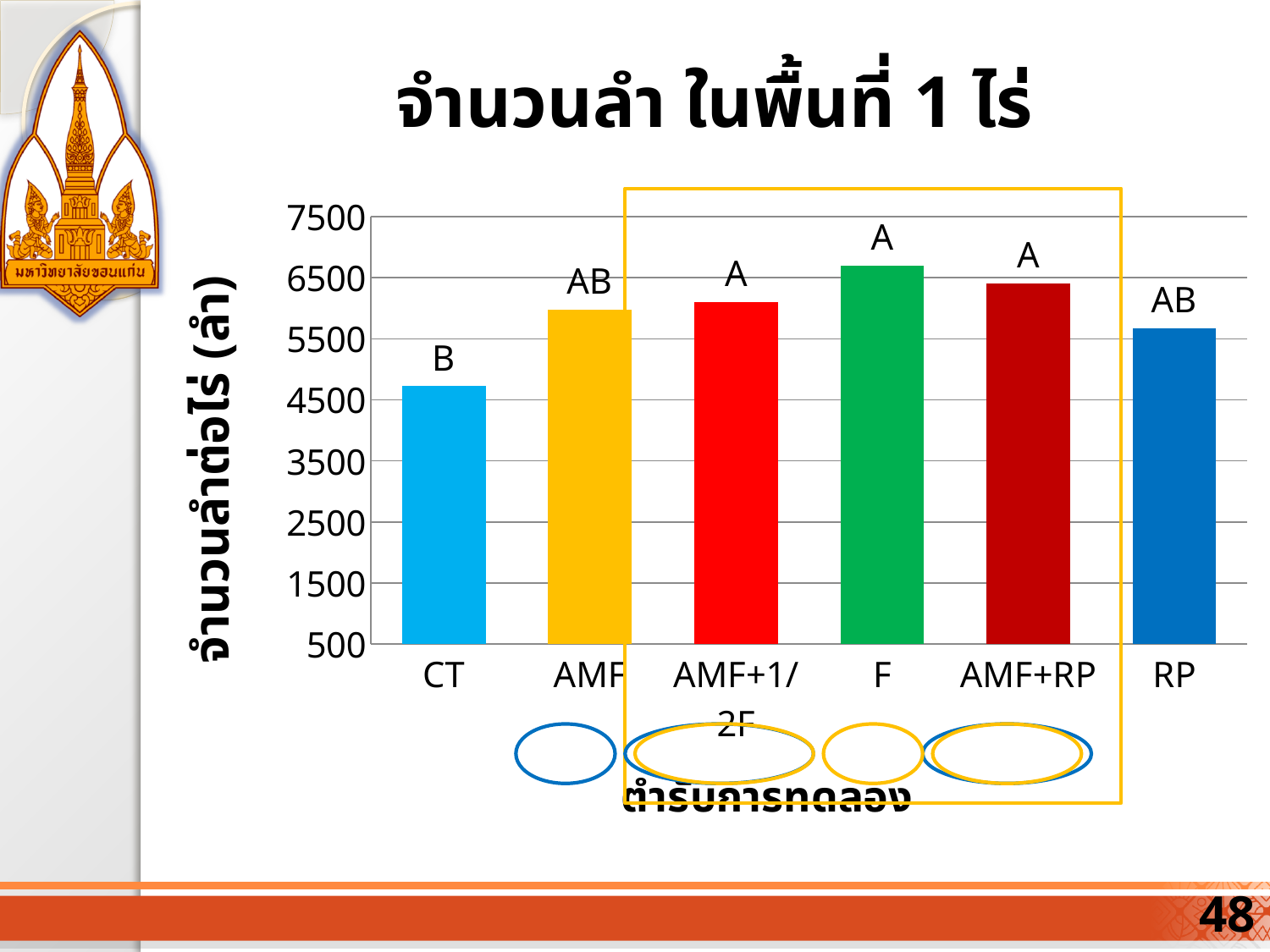
Which treatment has the highest number of stalks per rai? F What kind of chart is shown on the slide? bar chart What statistical letter label is printed above the CT bar? B How many categories (treatments) are shown on the x axis of the chart? 6 Is the value for RP greater or less than 6500? less Which treatment has the lowest number of stalks per rai? CT What is the title of the chart? จำนวนลำ ในพื้นที่ 1 ไร่ Which is larger, the value for F or the value for CT? F Is the value for AMF+RP greater or less than 5500? greater Which is larger, the value for AMF+RP or the value for RP? AMF+RP Is the value for CT greater or less than 5500? less